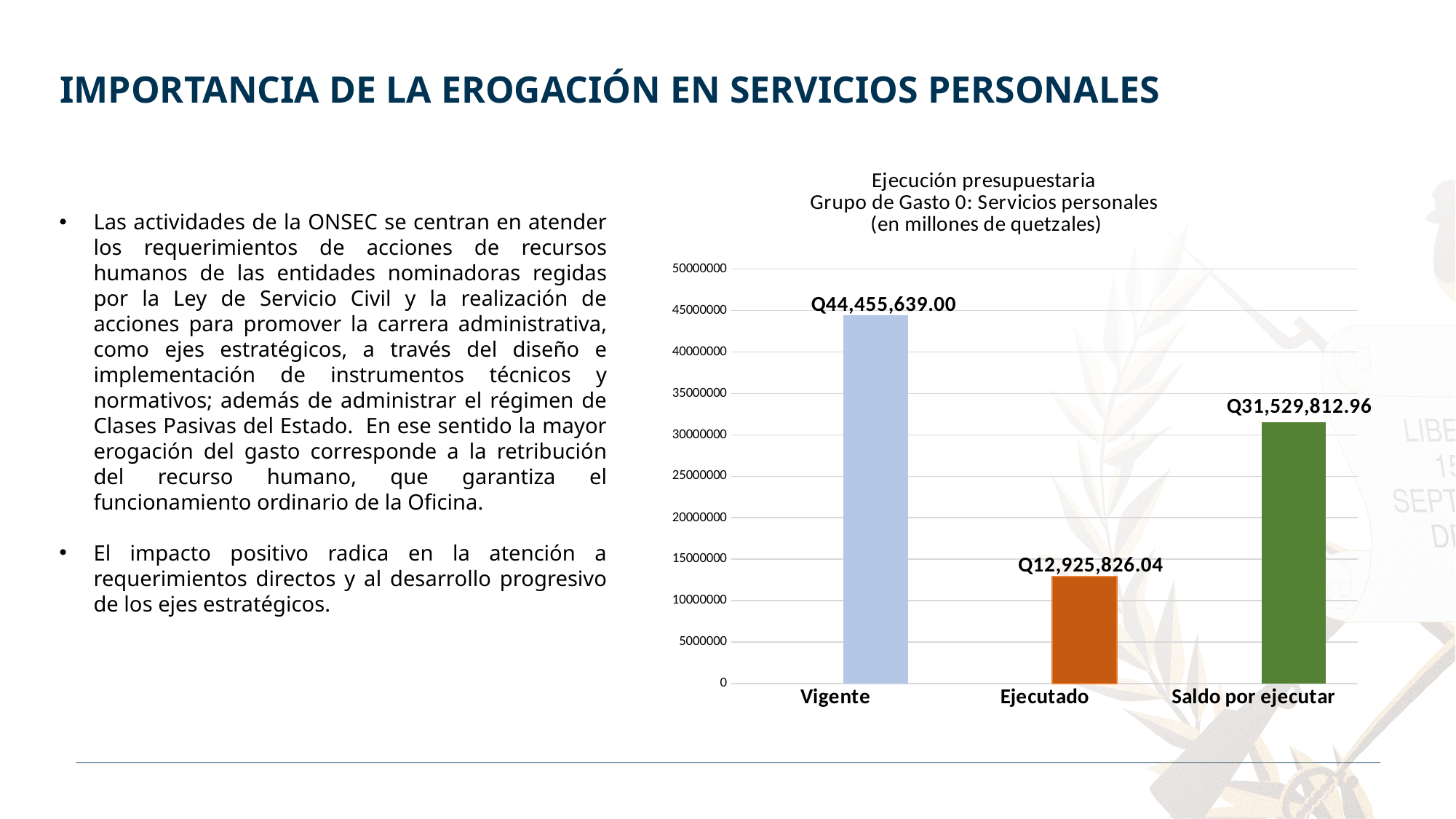
Which category has the highest value? Vigente What is the difference between the values for Vigente and Ejecutado? Q31,529,812.96 What is the value for Vigente? Q44,455,639.00 Which category has the lowest value? Ejecutado Which is larger, the value for Saldo por ejecutar or the value for Ejecutado? Saldo por ejecutar What is the title of the chart? Ejecución presupuestaria Grupo de Gasto 0: Servicios personales (en millones de quetzales) What is the difference between the values for Saldo por ejecutar and Ejecutado? Q18,603,986.92 How many categories are shown in the chart? 3 Is the value for Ejecutado greater or less than 15000000? less What kind of chart is shown on the slide? bar chart What is the value for Saldo por ejecutar? Q31,529,812.96 What is the value for Ejecutado? Q12,925,826.04